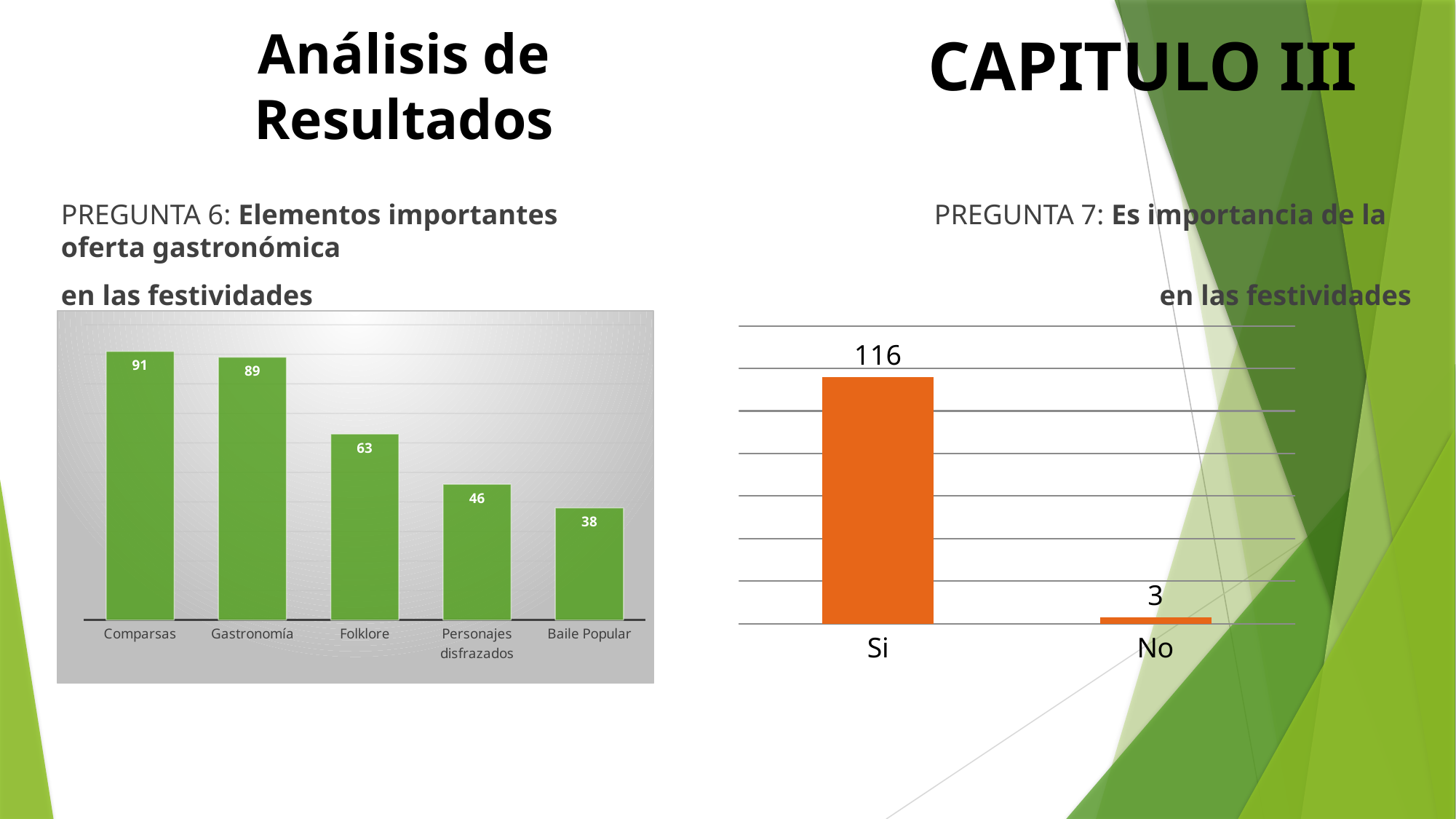
In the right chart (Pregunta 7), what is the value for Si? 116 In the right chart (Pregunta 7), what is the value for No? 3 How many categories are shown in the left chart (Pregunta 6)? 5 In the left chart (Pregunta 6), what is the value for Folklore? 63 In the left chart (Pregunta 6), which category has the highest value? Comparsas In the left chart (Pregunta 6), what is the value for Baile Popular? 38 What kind of chart is the right chart (Pregunta 7)? bar chart In the right chart (Pregunta 7), what is the difference between Si and No? 113 In the left chart (Pregunta 6), which category has the lowest value? Baile Popular In the left chart (Pregunta 6), do the values rise or fall from left to right? fall In the left chart (Pregunta 6), which is larger, Folklore or Personajes disfrazados? Folklore In the left chart (Pregunta 6), what is the difference between Comparsas and Personajes disfrazados? 45